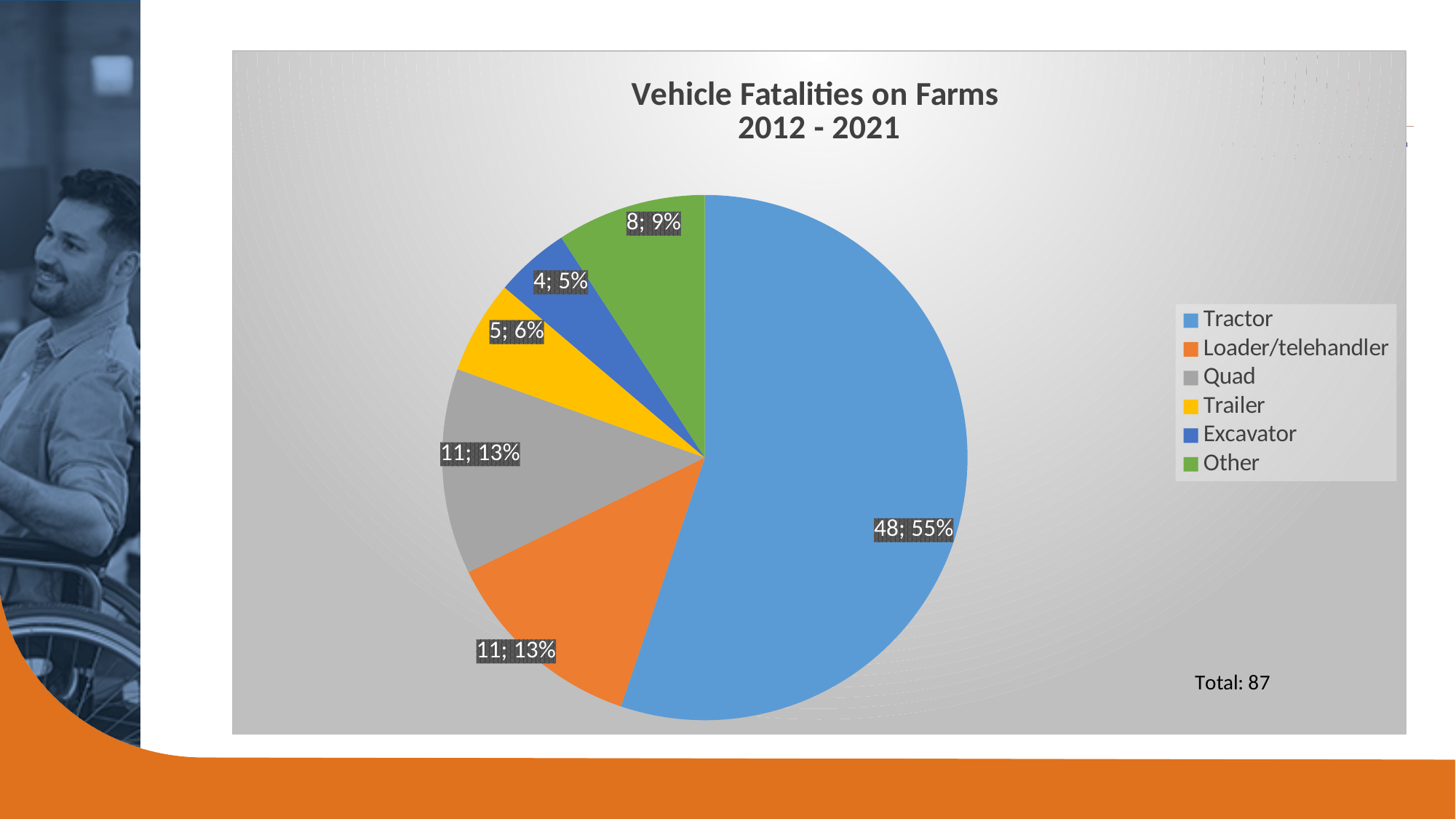
What is the title of the chart? Vehicle Fatalities on Farms 2012 - 2021 Which category has the largest slice? Tractor How many categories does the legend list? 6 What kind of chart is shown on the slide? pie chart What percentage share of the pie does Other represent? 9% Which is larger, the Trailer slice or the Other slice? Other Which category has the smallest slice? Excavator What percentage share of the pie does Tractor represent? 55% What total is printed on the chart? Total: 87 How many fatalities are attributed to Excavator? 4 What is the difference between the Tractor count and the Quad count? 37 How many fatalities are attributed to Tractor? 48